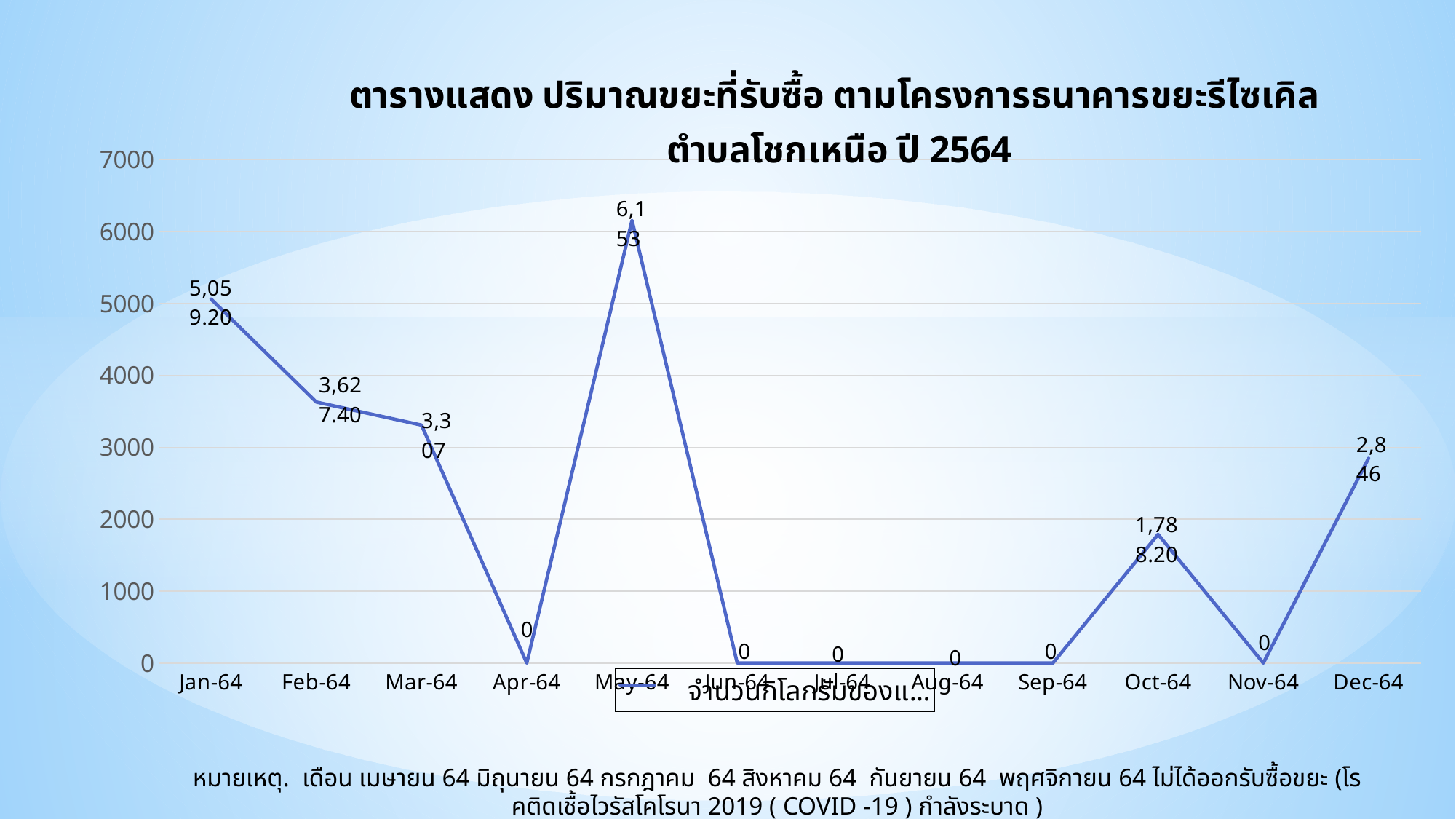
Do the values rise or fall from Jan-64 to Apr-64? fall Which is larger, the value for Jan-64 or the value for Feb-64? Jan-64 Which month has the highest value? May-64 What is the difference between the values for Dec-64 and Oct-64? 1,057.80 How many months have a value of 0? 6 What kind of chart is shown on the slide? line chart What is the value for Dec-64? 2,846 What is the value for Jan-64? 5,059.20 What is the value for Apr-64? 0 How many months are plotted along the x axis? 12 Is the value for Oct-64 greater or less than 2000? less What is the value for May-64? 6,153